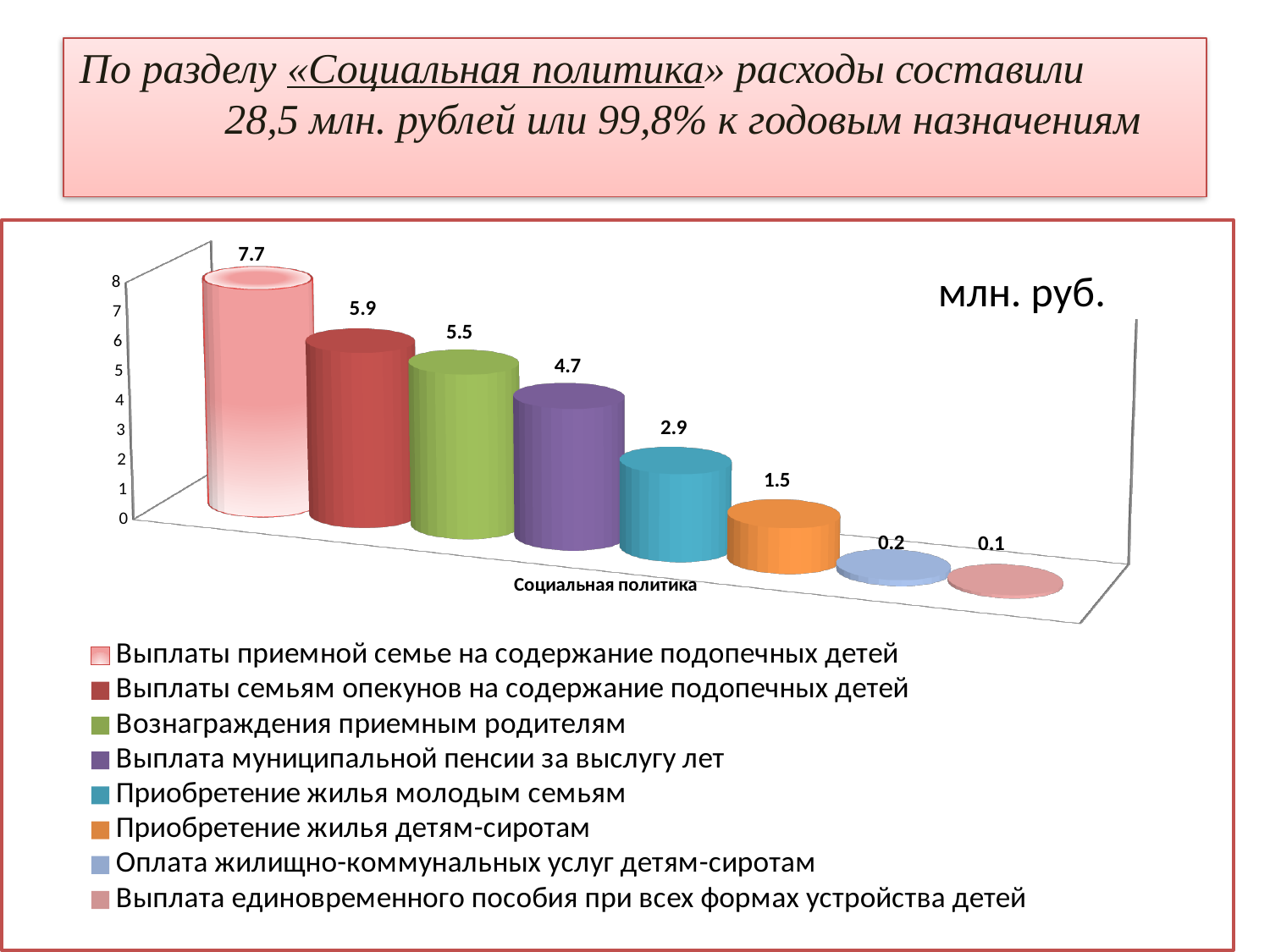
Which is larger: «Приобретение жилья молодым семьям» or «Приобретение жилья детям-сиротам»? Приобретение жилья молодым семьям What is the value for «Выплаты приемной семье на содержание подопечных детей»? 7.7 What kind of chart is shown on the slide? bar chart What is the category label shown on the x axis? Социальная политика What is the value for «Выплата муниципальной пенсии за выслугу лет»? 4.7 What is the value for «Приобретение жилья детям-сиротам»? 1.5 How many series does the legend list? 8 Which series has the lowest value? Выплата единовременного пособия при всех формах устройства детей What unit is indicated on the chart? млн. руб. What is the difference between «Выплаты семьям опекунов на содержание подопечных детей» and «Вознаграждения приемным родителям»? 0.4 Which series has the highest value? Выплаты приемной семье на содержание подопечных детей Is the value for «Выплаты семьям опекунов на содержание подопечных детей» greater or less than 5? greater